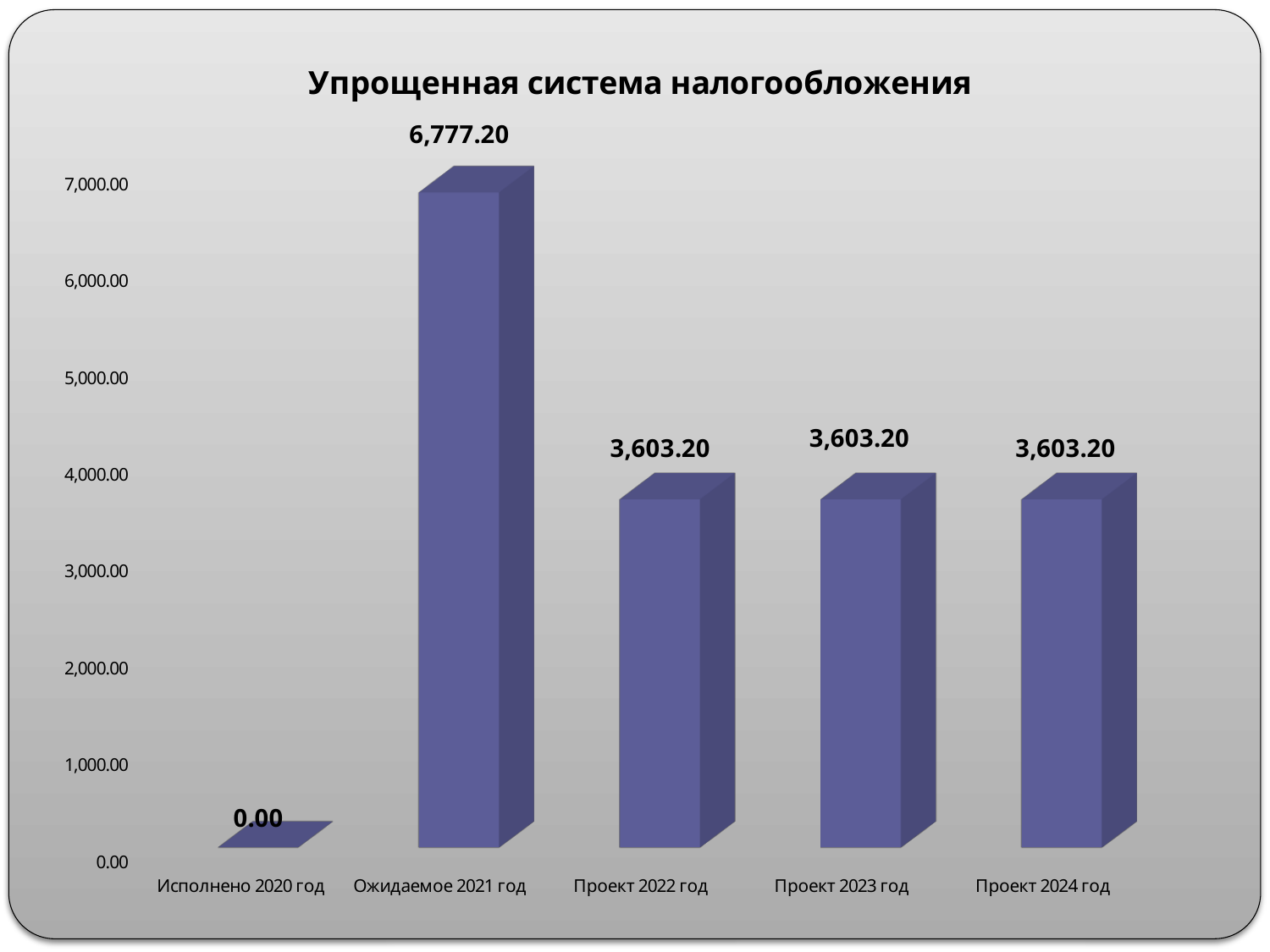
What is the value for Исполнено 2020 год? 0.00 Is the value for Проект 2023 год greater or less than 4,000.00? less Which category has the highest value? Ожидаемое 2021 год Which is larger, the value for Ожидаемое 2021 год or the value for Проект 2023 год? Ожидаемое 2021 год How many categories are shown on the x axis? 5 What is the value for Проект 2022 год? 3,603.20 What is the title of the chart? Упрощенная система налогообложения What is the difference between the values for Ожидаемое 2021 год and Проект 2022 год? 3,174.00 What is the value for Ожидаемое 2021 год? 6,777.20 What is the value for Проект 2024 год? 3,603.20 What kind of chart is shown on the slide? bar chart Which category has the lowest value? Исполнено 2020 год